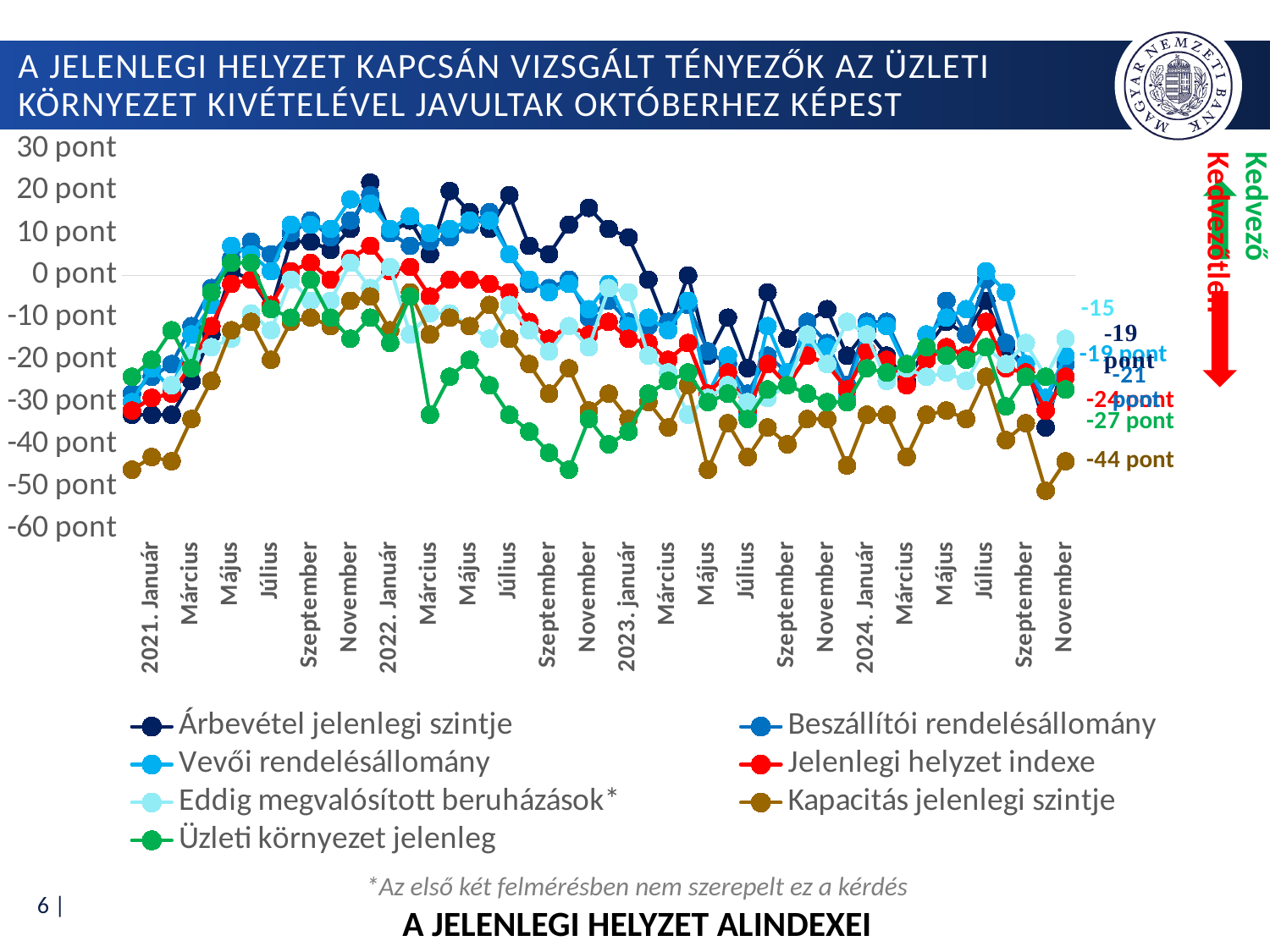
What is the final value labelled for Jelenlegi helyzet indexe? -24 pont At the end of the chart, which is larger: the value for Jelenlegi helyzet indexe or the value for Kapacitás jelenlegi szintje? Jelenlegi helyzet indexe Which series has the lowest value at the end of the chart (November 2024)? Kapacitás jelenlegi szintje Does the Kapacitás jelenlegi szintje series rise or fall between 2021. Január and Május 2021? rise What is the final value labelled for Üzleti környezet jelenleg? -27 pont What kind of chart is shown on the slide? line chart What is the final (November 2024) value labelled for Kapacitás jelenlegi szintje? -44 pont What is the highest tick shown on the vertical axis? 30 pont How many series does the legend list? 7 Is the value for Kapacitás jelenlegi szintje in 2021. Január greater or less than -40 pont? less What is the difference between the final values of Üzleti környezet jelenleg (-27 pont) and Kapacitás jelenlegi szintje (-44 pont)? 17 pont What colour is the line for Kapacitás jelenlegi szintje in the legend? brown